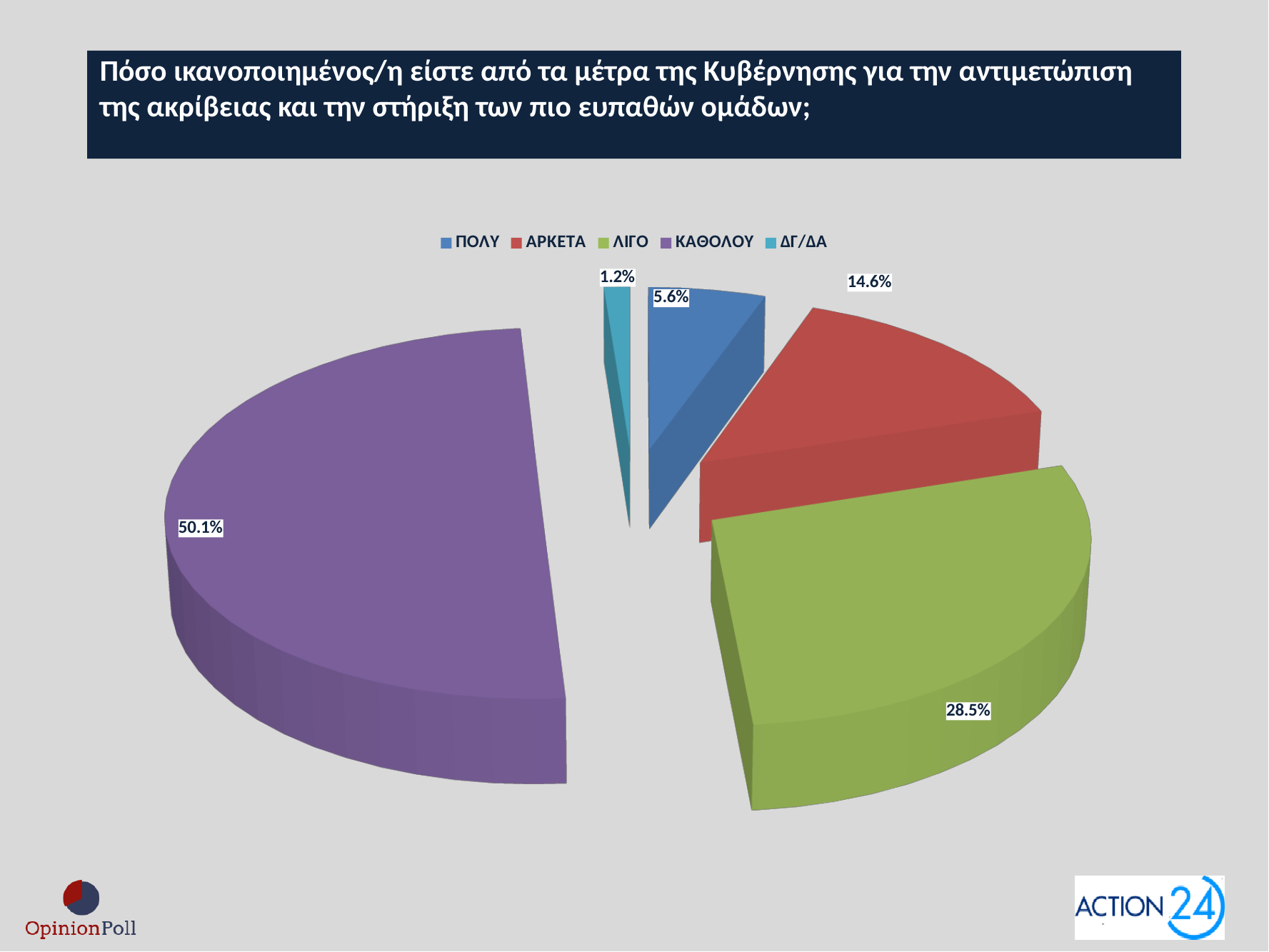
Which is larger, the value for ΑΡΚΕΤΑ or the value for ΠΟΛΥ? ΑΡΚΕΤΑ What is the value for ΑΡΚΕΤΑ? 14.6% What is the value for ΛΙΓΟ? 28.5% What is the value for ΚΑΘΟΛΟΥ? 50.1% Which category has the smallest share of the pie? ΔΓ/ΔΑ What colour is the slice for ΛΙΓΟ? green How many categories does the legend list? 5 Which category has the largest share of the pie? ΚΑΘΟΛΟΥ What is the value for ΠΟΛΥ? 5.6% What type of chart is shown on the slide? pie chart What is the value for ΔΓ/ΔΑ? 1.2% What is the difference between the values for ΚΑΘΟΛΟΥ and ΛΙΓΟ? 21.6%